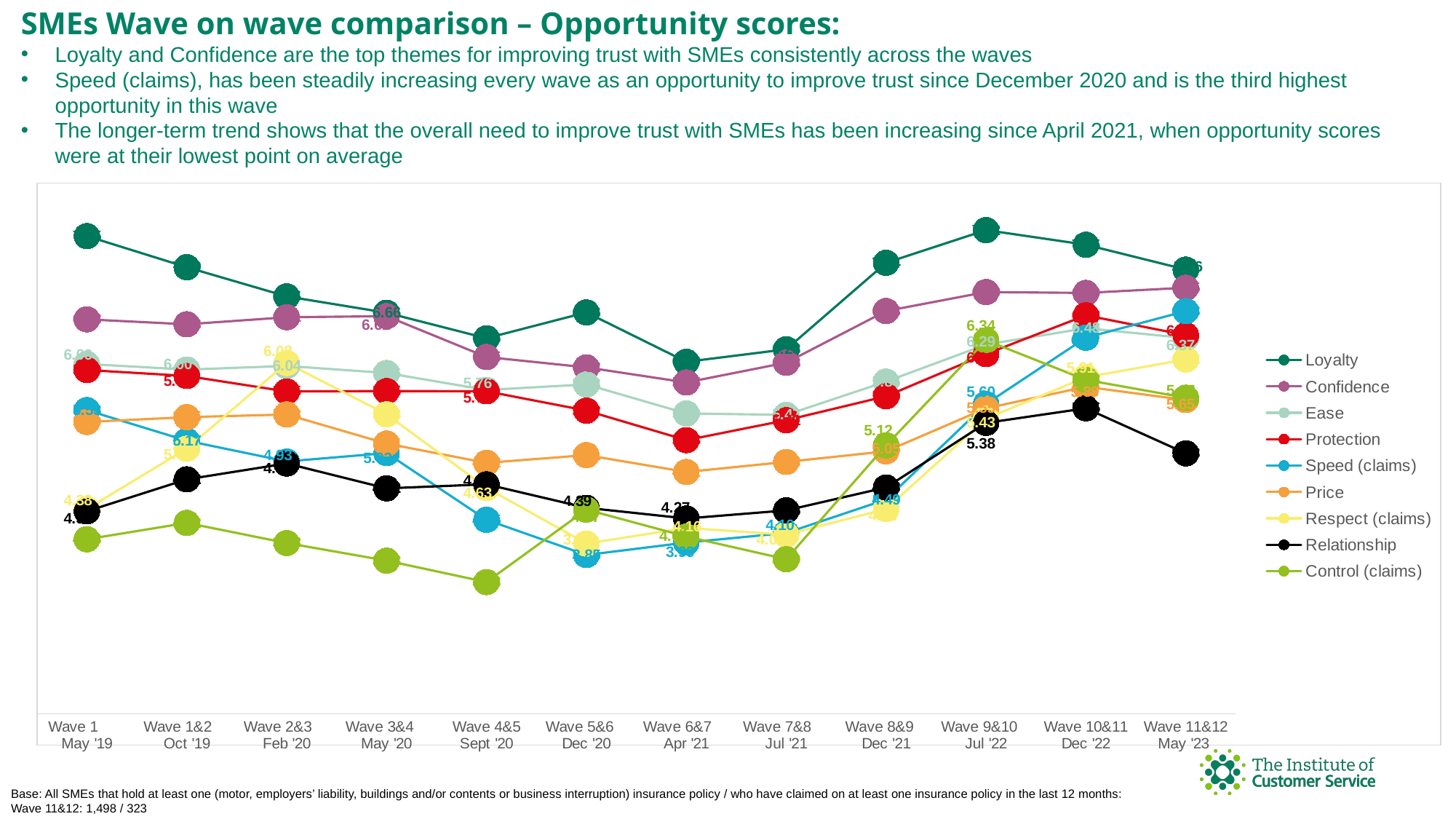
What is the value for Relationship at Wave 9&10 (Jul '22)? 5.38 What is the value for Control (claims) at Wave 9&10 (Jul '22)? 6.34 Does the Loyalty line rise or fall from Wave 1 (May '19) to Wave 6&7 (Apr '21)? Fall Which series has the highest value at Wave 1 (May '19)? Loyalty How many series does the legend list? 9 Which series has the highest value at Wave 11&12 (May '23)? Loyalty What is the title of the chart slide? SMEs Wave on wave comparison – Opportunity scores: What kind of chart is shown on the slide? Line chart Which series has the lowest value at Wave 11&12 (May '23)? Relationship How many waves are shown along the x axis? 12 At Wave 9&10 (Jul '22), which is larger: Loyalty or Confidence? Loyalty Which series has the lowest value at Wave 4&5 (Sept '20)? Control (claims)